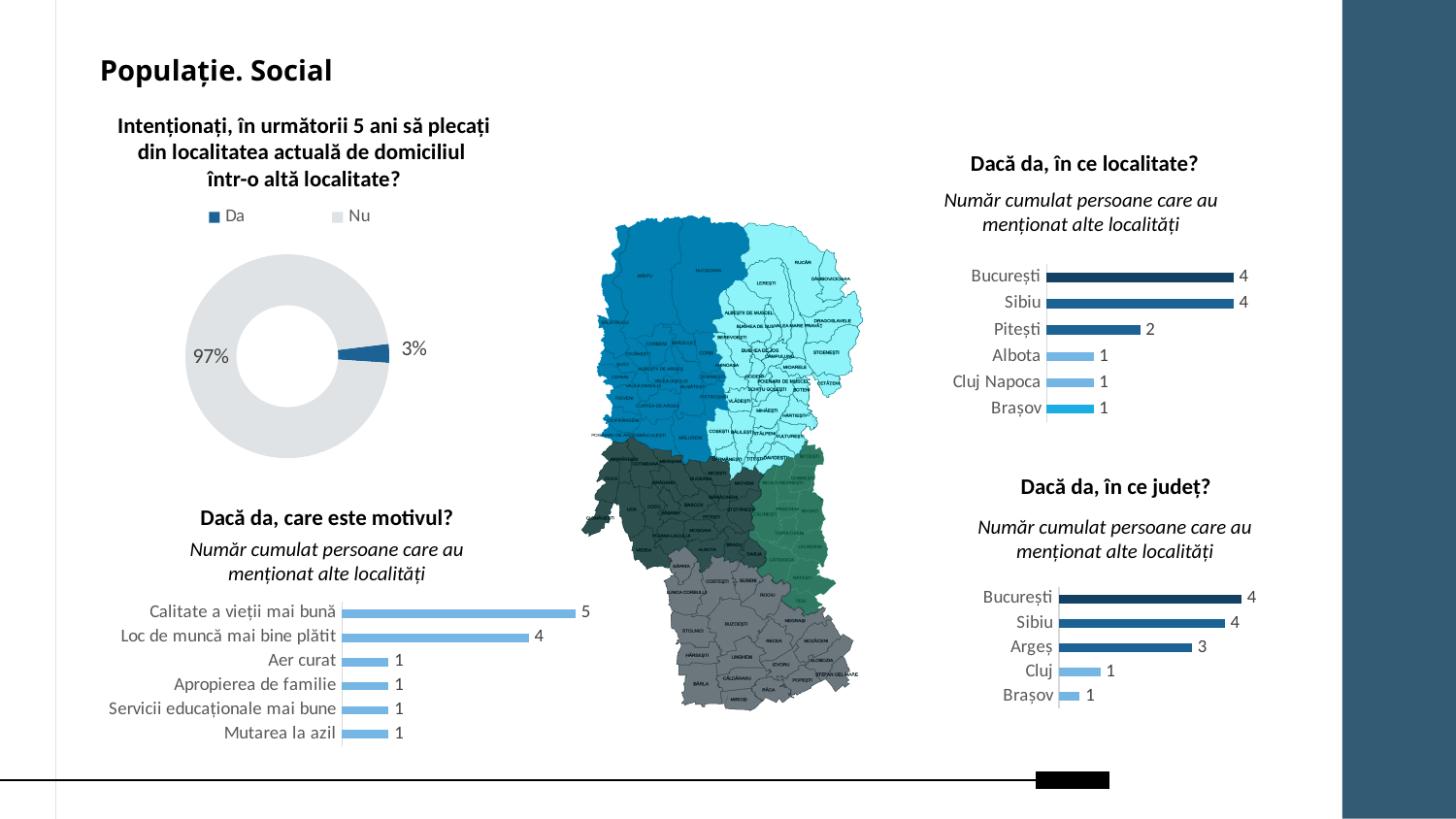
In the donut chart about intending to leave the current locality in the next 5 years, what share answered "Nu"? 97% What kind of chart is used for the "Intenționați, în următorii 5 ani să plecați..." question? Donut (pie) chart In the "Dacă da, în ce localitate?" chart, what is the value for Pitești? 2 In the "Dacă da, care este motivul?" chart, what is the value for "Calitate a vieții mai bună"? 5 In the "Dacă da, în ce localitate?" chart, how many localities are listed? 6 In the donut chart about intending to leave the current locality in the next 5 years, what share answered "Da"? 3% In the "Dacă da, în ce județ?" chart, which is larger, the value for Argeș or the value for Cluj? Argeș What kind of chart is "Dacă da, în ce județ?"? Bar chart In the "Dacă da, care este motivul?" chart, what is the difference between "Calitate a vieții mai bună" and "Loc de muncă mai bine plătit"? 1 In the "Dacă da, în ce județ?" chart, what is the value for Argeș? 3 In the "Dacă da, care este motivul?" chart, which reason has the highest value? Calitate a vieții mai bună In the "Dacă da, care este motivul?" chart, how many reasons are listed? 6